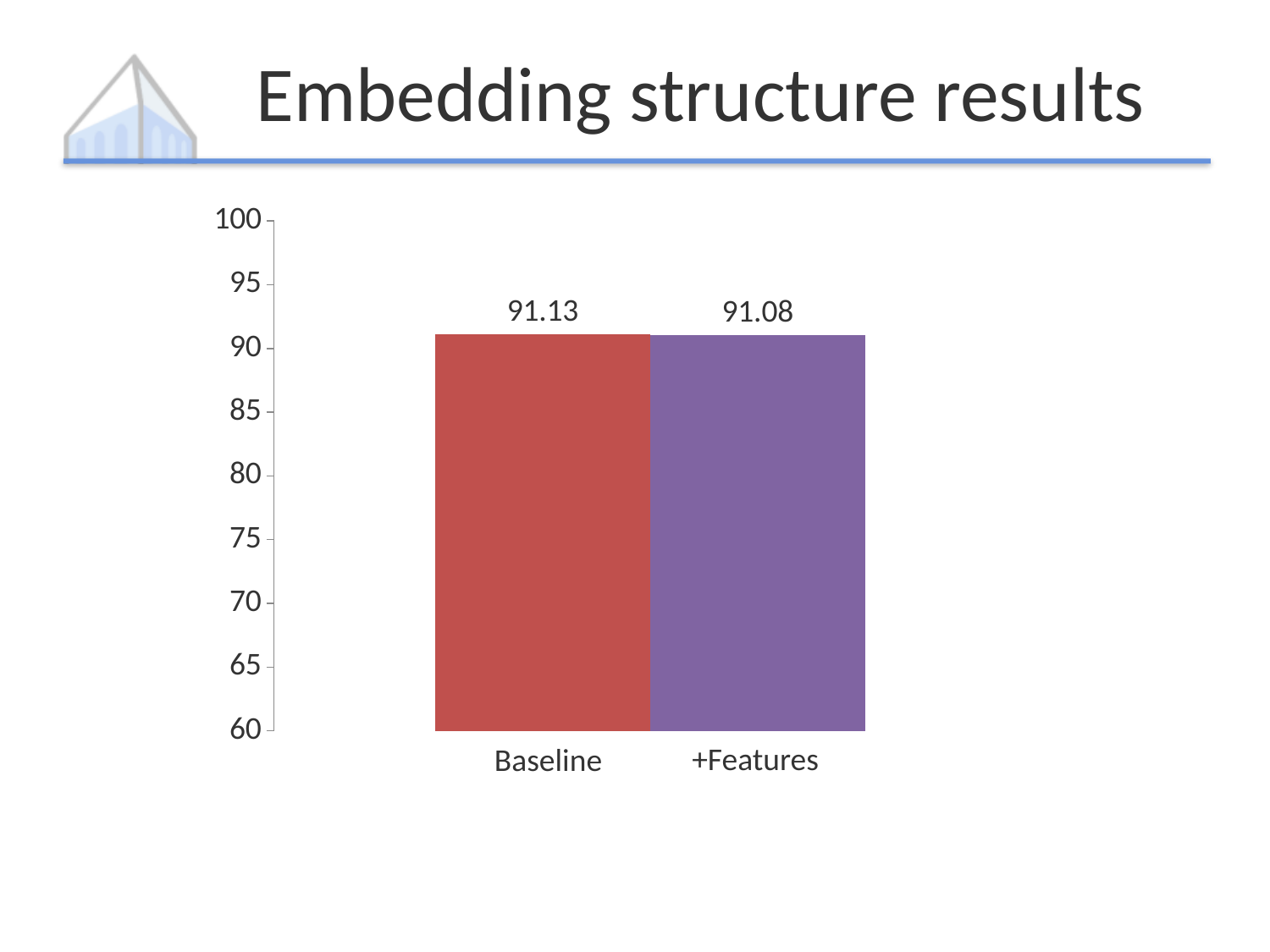
What is the lowest value shown on the y axis? 60 What is the value for +Features? 91.08 What is the title of the slide containing the chart? Embedding structure results Is the value for +Features greater or less than 95? less Is the value for Baseline greater or less than 90? greater Which category has the lowest value? +Features Which is larger, the value for Baseline or the value for +Features? Baseline What is the difference between the Baseline value and the +Features value? 0.05 What is the value for Baseline? 91.13 How many categories are shown on the x axis? 2 Which category has the highest value? Baseline What kind of chart is shown on the slide? bar chart